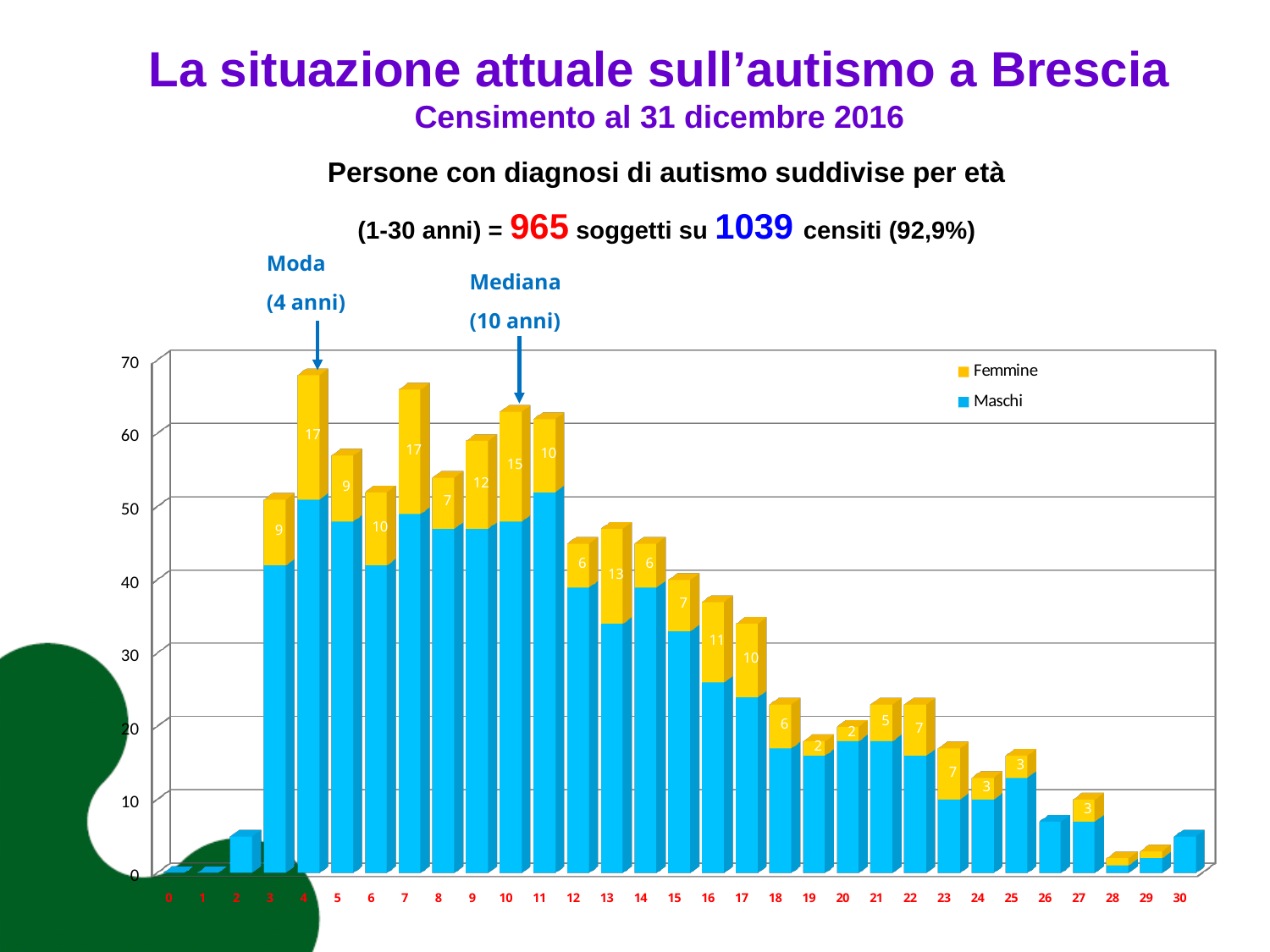
How many age categories are shown on the x axis? 31 Is the total value of the bar for age 26 greater or less than 10? less What kind of chart is shown on the slide? bar chart Is the total value of the bar for age 4 greater or less than 60? greater What is the Femmine value for age 10? 15 Do the bar totals rise or fall from age 11 to age 20? fall What is the Femmine value for age 4? 17 What are the two series named in the legend? Femmine and Maschi Which has the larger Femmine value, age 12 or age 13? age 13 What is the Femmine value for age 13? 13 What is the difference between the Femmine values for age 4 and age 8? 10 How many series does the legend list? 2